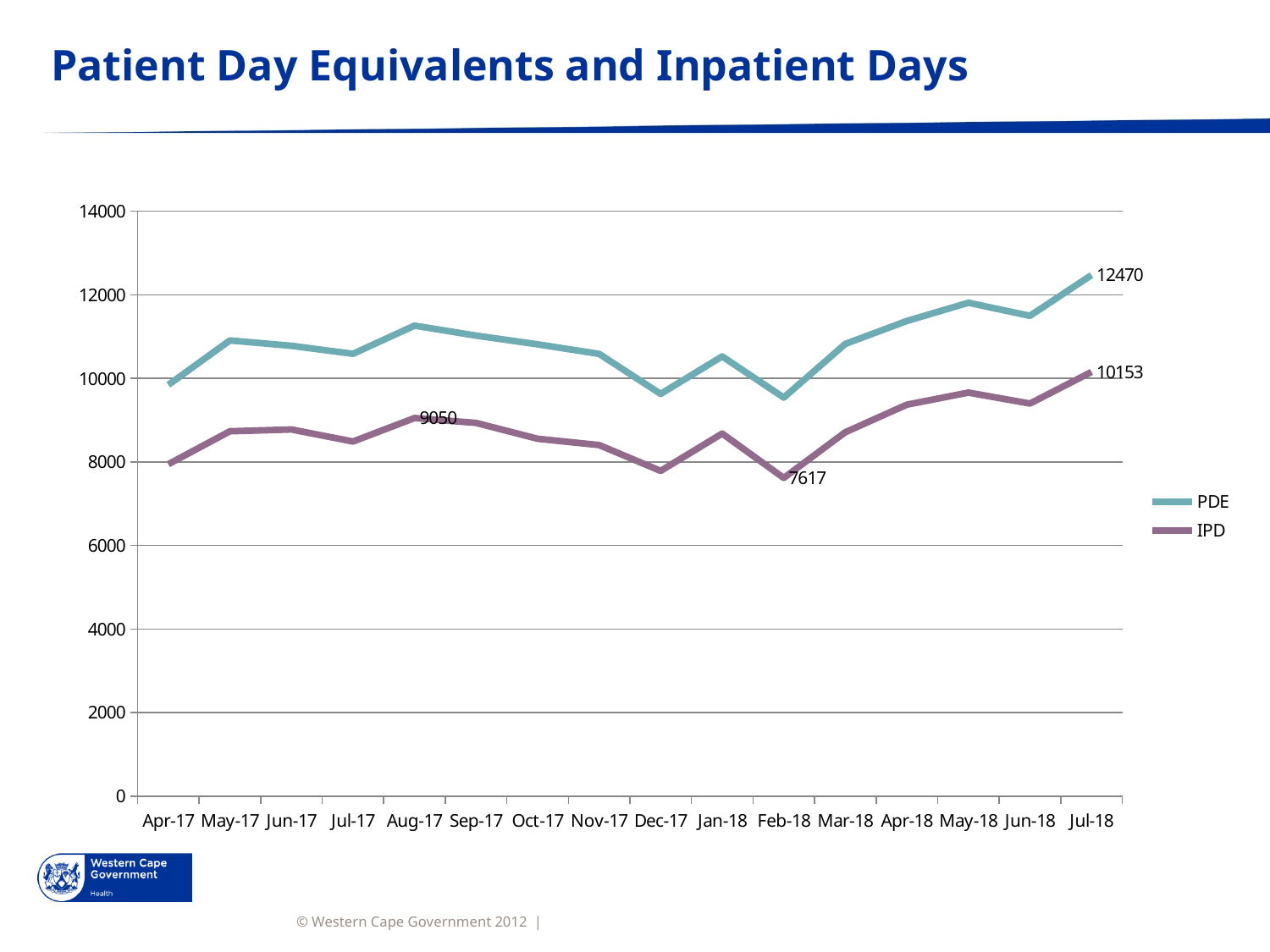
Is the IPD value for Jan-18 greater or less than 8000? greater Which series has the higher value in Jul-18, PDE or IPD? PDE By how much did IPD increase from Feb-18 to Jul-18? 2536 In which month does PDE reach its highest value? Jul-18 What is the IPD value for Feb-18? 7617 What is the PDE value for Jul-18? 12470 What is the difference between the PDE and IPD values in Jul-18? 2317 What is the IPD value for Jul-18? 10153 How many series does the legend list? 2 What is the IPD value for Aug-17? 9050 Is the PDE value for May-17 greater or less than 10000? greater How many months are shown on the x axis? 16